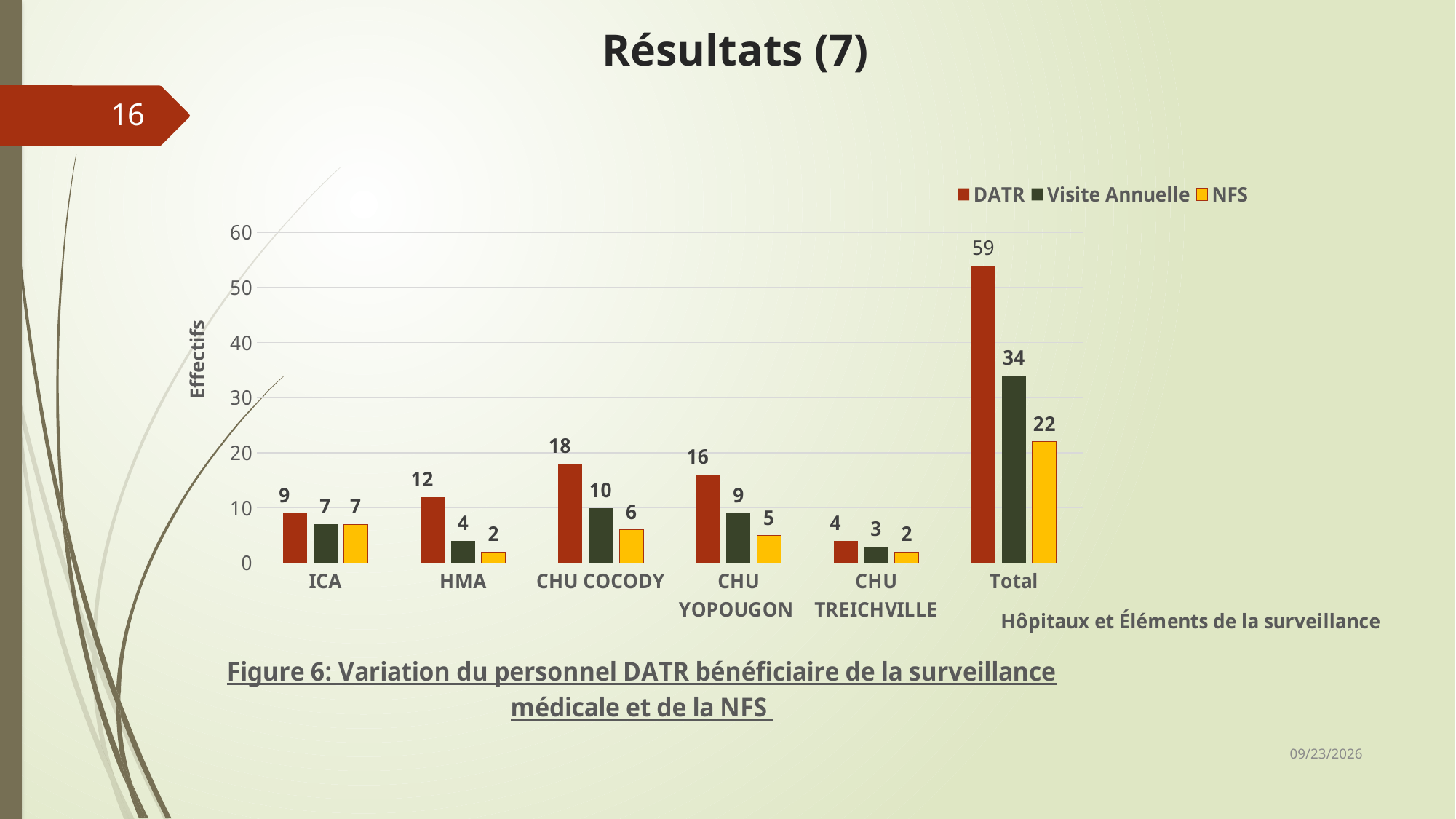
Excluding Total, which hospital has the highest DATR value? CHU COCODY Which hospital has the lowest NFS value? HMA and CHU TREICHVILLE (both 2) Is the Visite Annuelle value for Total greater or less than 30? greater What is the DATR value for the Total category? 59 What is the Visite Annuelle value for HMA? 4 What is the DATR value for CHU COCODY? 18 What is the difference between the DATR and NFS values for CHU COCODY? 12 Which is larger, the Visite Annuelle value for ICA or the Visite Annuelle value for CHU TREICHVILLE? ICA How many categories are shown on the x axis? 6 What is the NFS value for CHU YOPOUGON? 5 What kind of chart is shown on the slide? Bar chart How many series does the legend list? 3